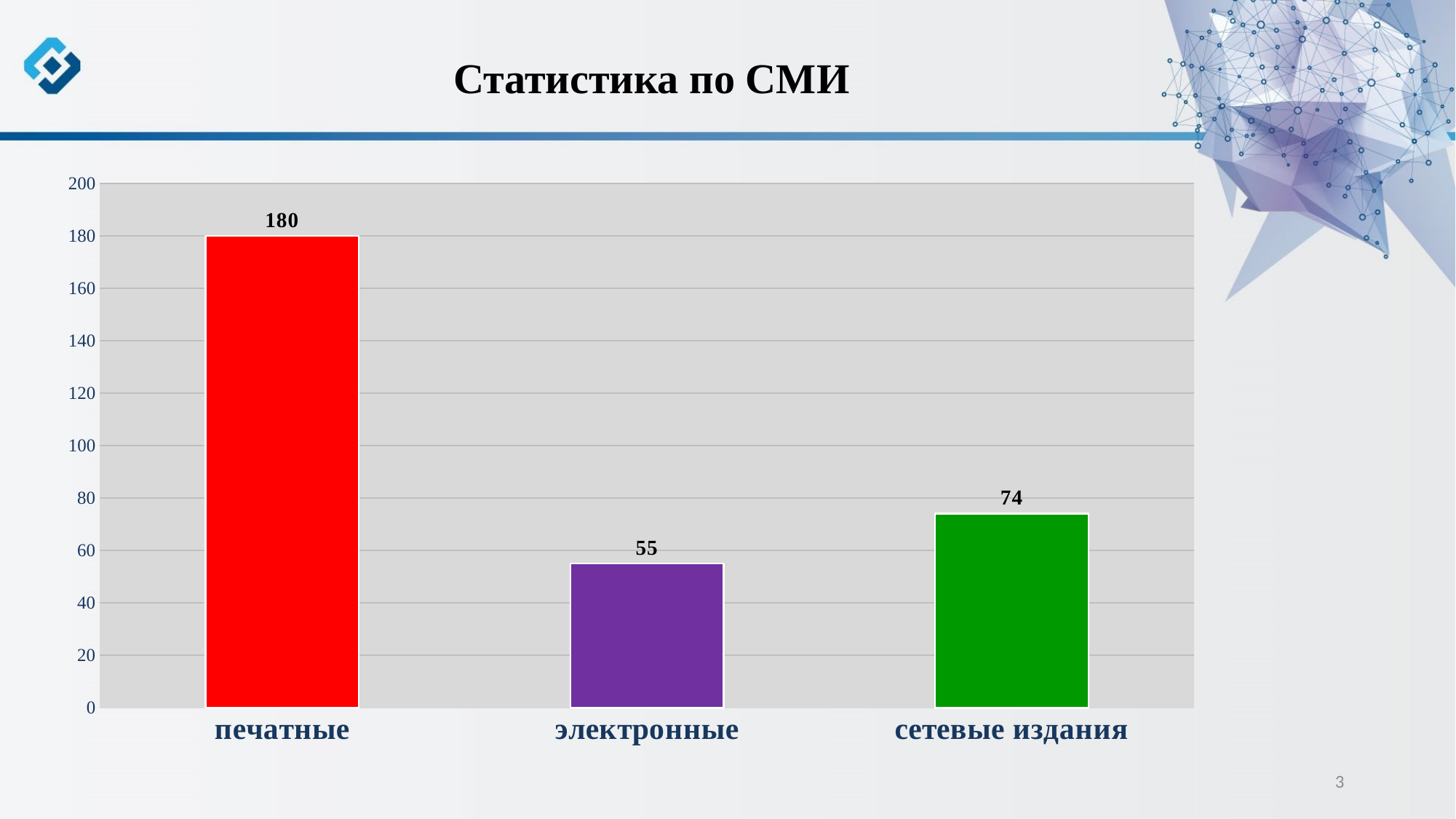
What kind of chart is shown on the slide? bar chart What is the difference between the values for сетевые издания and электронные? 19 Which category has the lowest value? электронные Which is larger, the value for электронные or the value for сетевые издания? сетевые издания What is the title of the slide? Статистика по СМИ How many categories are shown in the chart? 3 What is the difference between the values for печатные and сетевые издания? 106 What is the value for сетевые издания? 74 What is the value for печатные? 180 What is the value for электронные? 55 Is the value for печатные greater or less than 100? greater Which category has the highest value? печатные